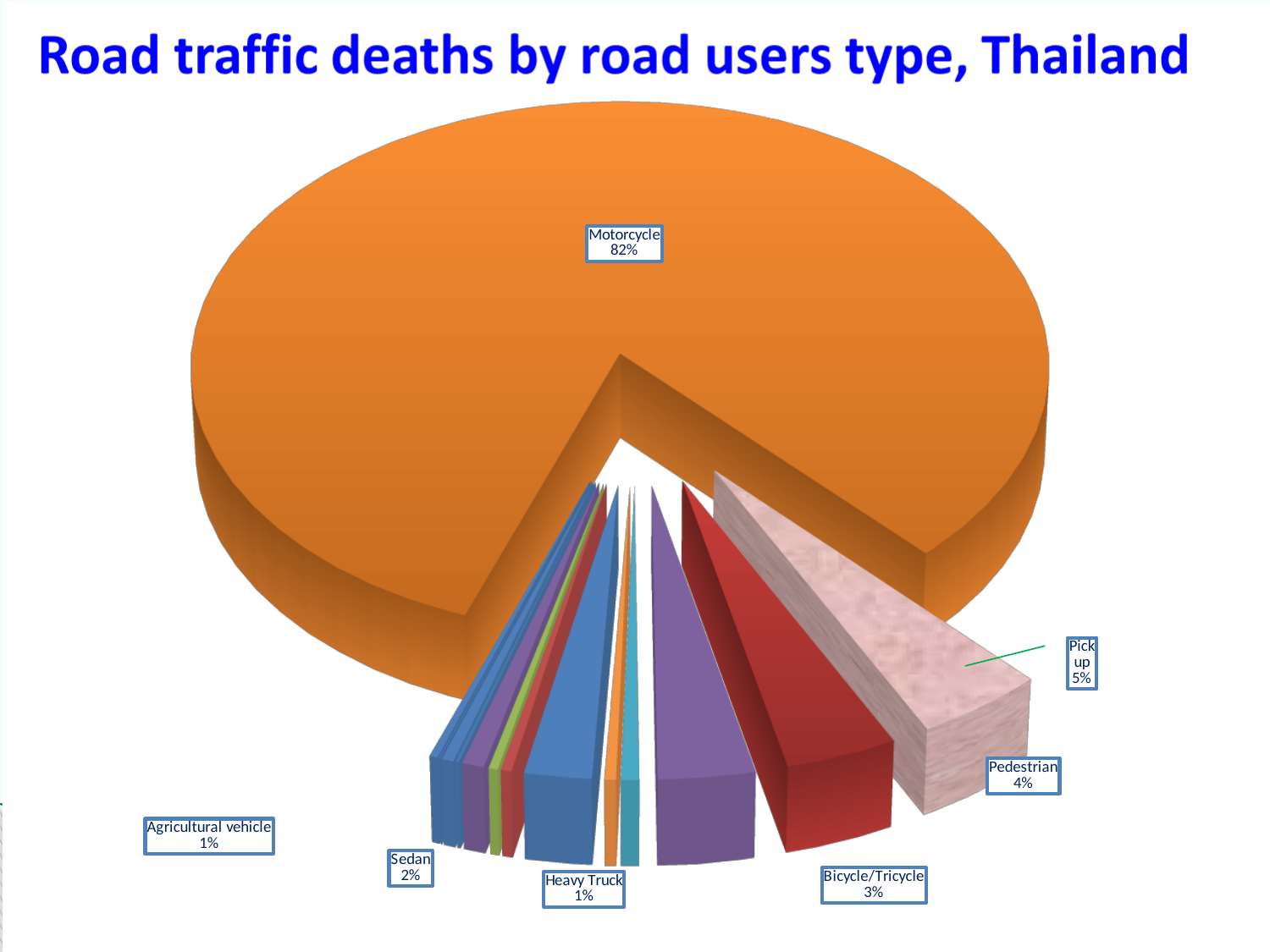
What is the share for Pedestrian? 4% What is the difference in percentage points between the Motorcycle share and the Pick up share? 77 What share of deaths is attributed to Sedan? 2% What share of road traffic deaths is attributed to Motorcycle? 82% Which is larger, the share for Pick up or the share for Pedestrian? Pick up Which road user type accounts for the largest share of road traffic deaths? Motorcycle What is the difference in percentage points between the Pedestrian share and the Sedan share? 2 What is the title of the chart? Road traffic deaths by road users type, Thailand What kind of chart is shown on the slide? Pie chart What percentage is shown for Heavy Truck? 1% What percentage is shown for Bicycle/Tricycle? 3% What percentage of road traffic deaths is shown for Pick up? 5%